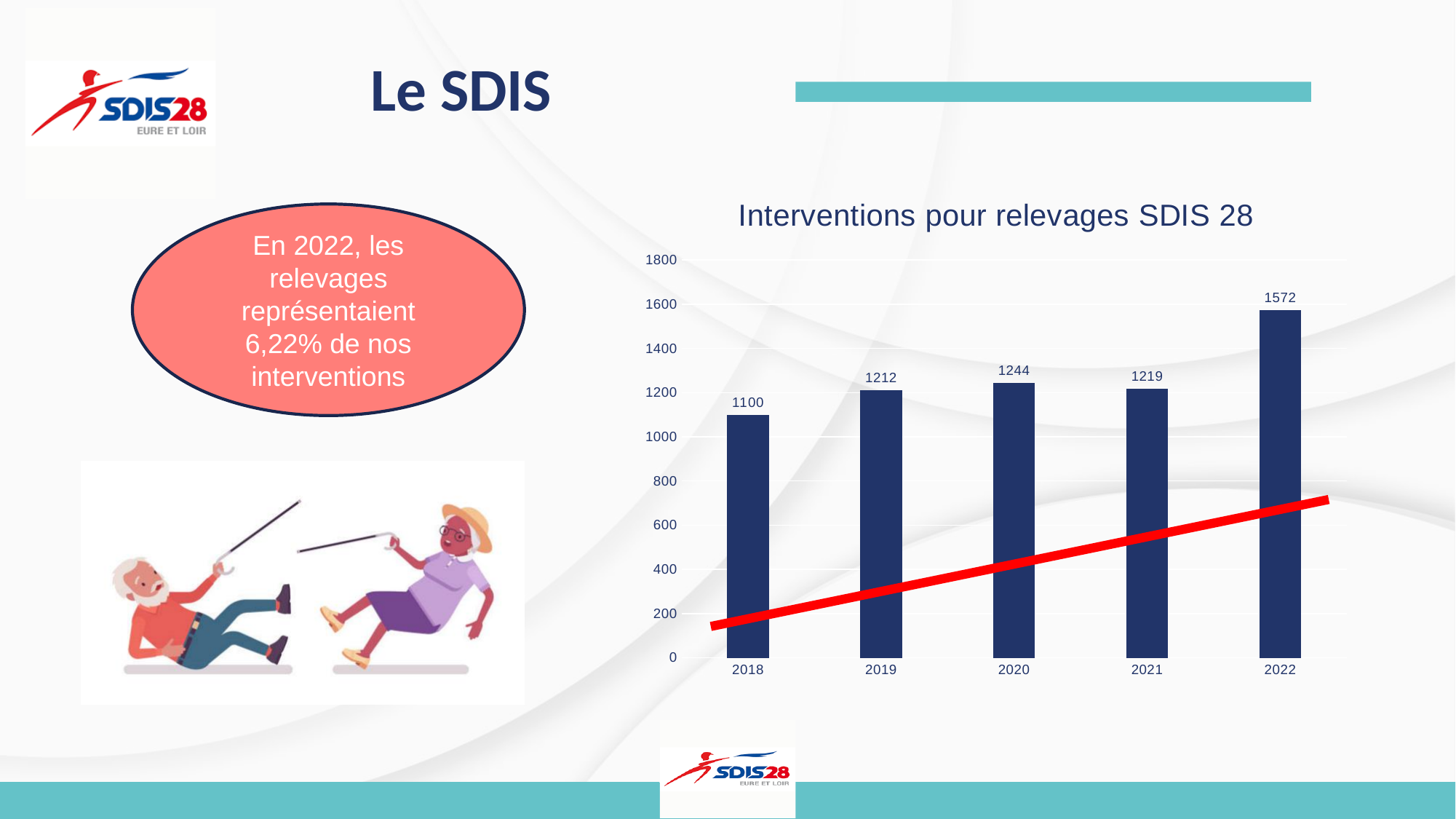
Which year has the lowest value? 2018 What is the title of the chart? Interventions pour relevages SDIS 28 What is the value for 2020 in the chart? 1244 Which is larger, the value for 2020 or the value for 2021? 2020 Which year has the highest value? 2022 What is the difference between the values for 2019 and 2018? 112 What kind of chart is shown on the slide? bar chart Is the value for 2022 greater or less than 1400? greater What is the value for 2018 in the chart? 1100 How many years are shown on the x axis? 5 What is the difference between the values for 2022 and 2021? 353 What is the value for 2022 in the chart? 1572